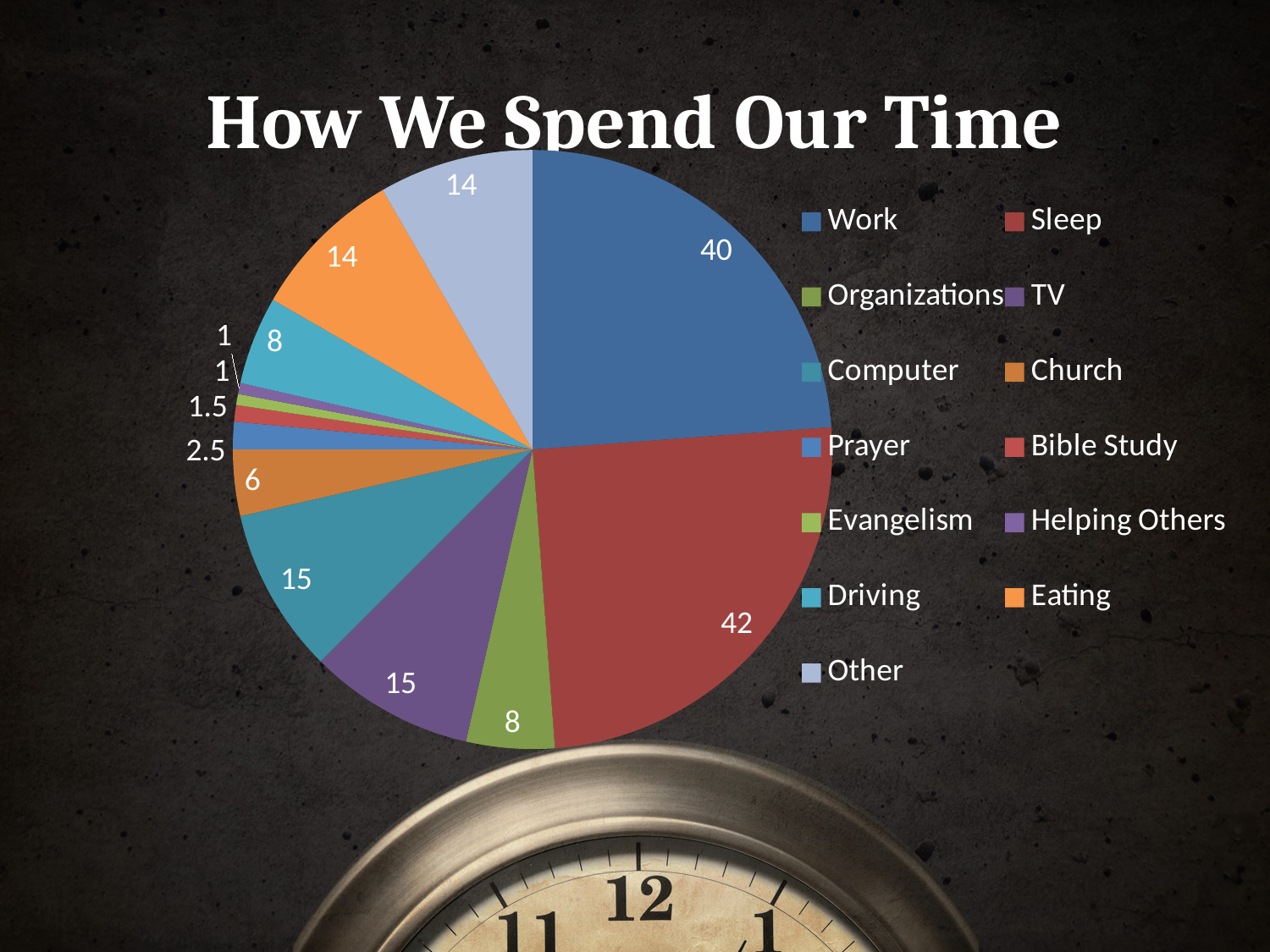
What is the value for Prayer in the pie chart? 2.5 What is the title of the chart? How We Spend Our Time How many categories does the pie chart show? 13 What is the value for Bible Study in the pie chart? 1.5 What is the value for Work in the pie chart? 40 What type of chart is shown on the slide? Pie chart What is the value for Sleep in the pie chart? 42 What is the value for Church in the pie chart? 6 What is the difference between the values for Sleep and Work? 2 What is the difference between the values for TV and Church? 9 Which is larger, the value for Eating or the value for Driving? Eating Which category has the largest slice of the pie chart? Sleep